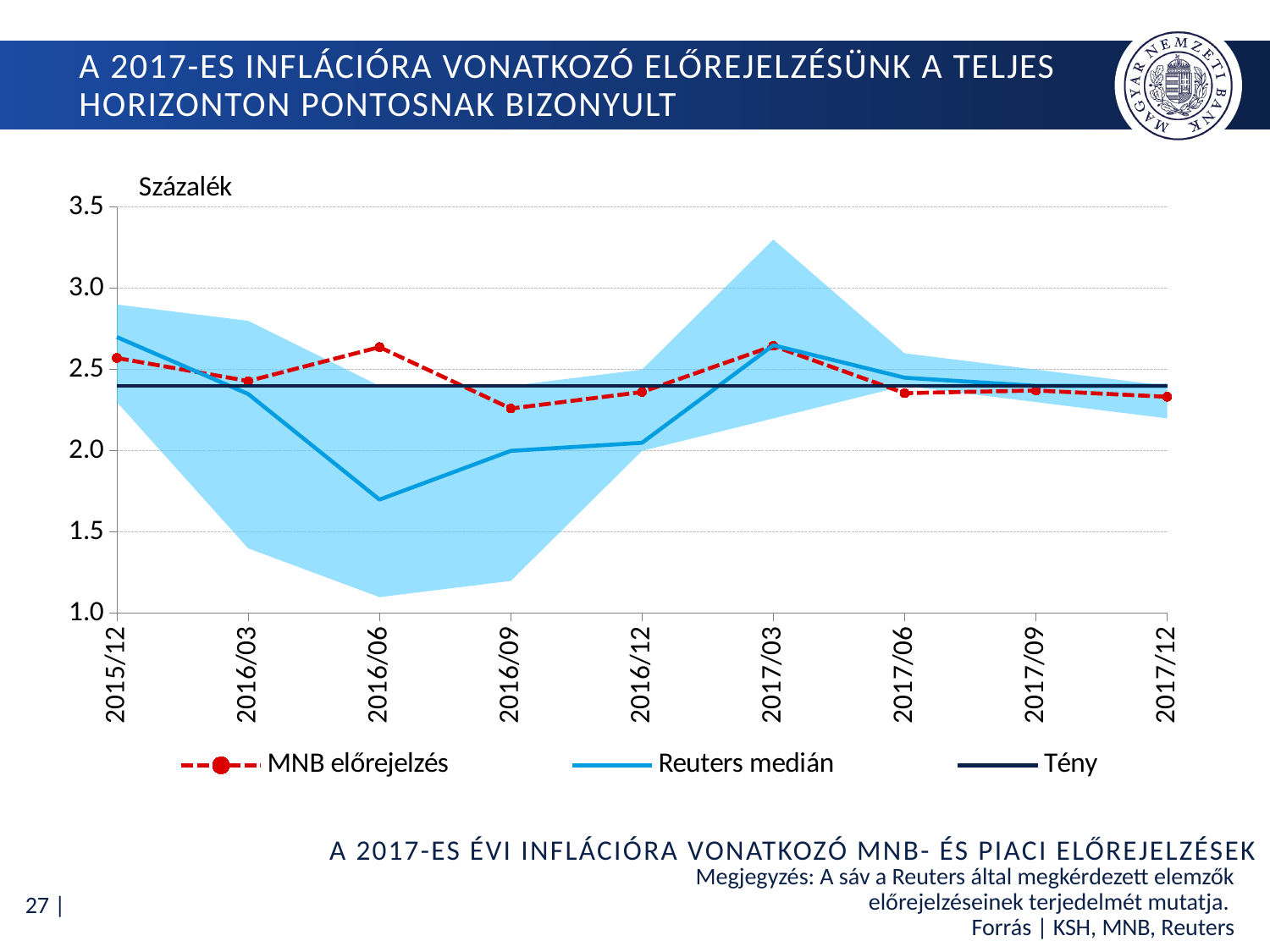
How many series does the legend list? 3 Is the value for Reuters medián at 2016/06 greater or less than 2.0? less Does the Reuters medián series rise or fall from 2015/12 to 2016/06? fall Which x-axis point has the lowest value for Reuters medián? 2016/06 At 2016/06, which is larger: MNB előrejelzés or Reuters medián? MNB előrejelzés Is the value for Reuters medián at 2017/03 greater or less than 2.5? greater What kind of chart is shown on the slide? line chart How many points are there along the x axis? 9 Is the value for MNB előrejelzés at 2016/09 greater or less than 2.5? less What unit is shown on the vertical axis label? Százalék At 2015/12, which is larger: MNB előrejelzés or Reuters medián? Reuters medián